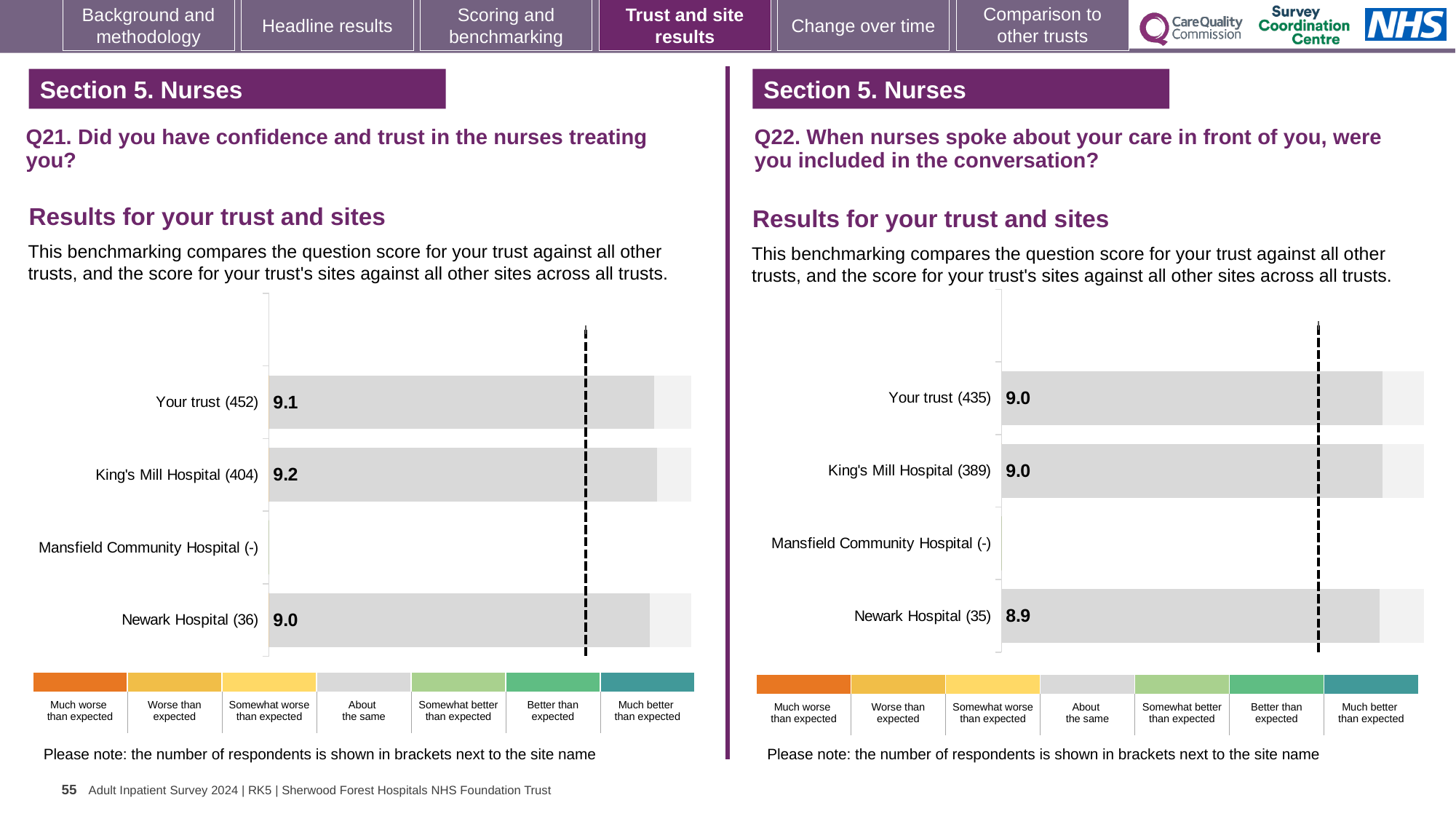
In the Q21 chart (left), what is the score for King's Mill Hospital? 9.2 In the Q22 chart (right), is the score for Your trust larger or smaller than the score for Newark Hospital? larger In the Q21 chart (left), what is the score for Your trust? 9.1 In the Q21 chart (left), what is the score for Newark Hospital? 9.0 In the Q22 chart (right), what is the score for Your trust? 9.0 In the Q22 chart (right), how many respondents are shown in brackets for King's Mill Hospital? 389 How many categories (rows) are listed on the y axis of the Q21 chart (left)? 4 In the Q21 chart (left), which site has the highest score? King's Mill Hospital What kind of chart is used for the Q22 results (right)? bar chart In the Q22 chart (right), what is the score for Newark Hospital? 8.9 In the Q21 chart (left), what is the difference between the King's Mill Hospital score and the Newark Hospital score? 0.2 In the Q22 chart (right), which site has the lowest score among those with a score shown? Newark Hospital